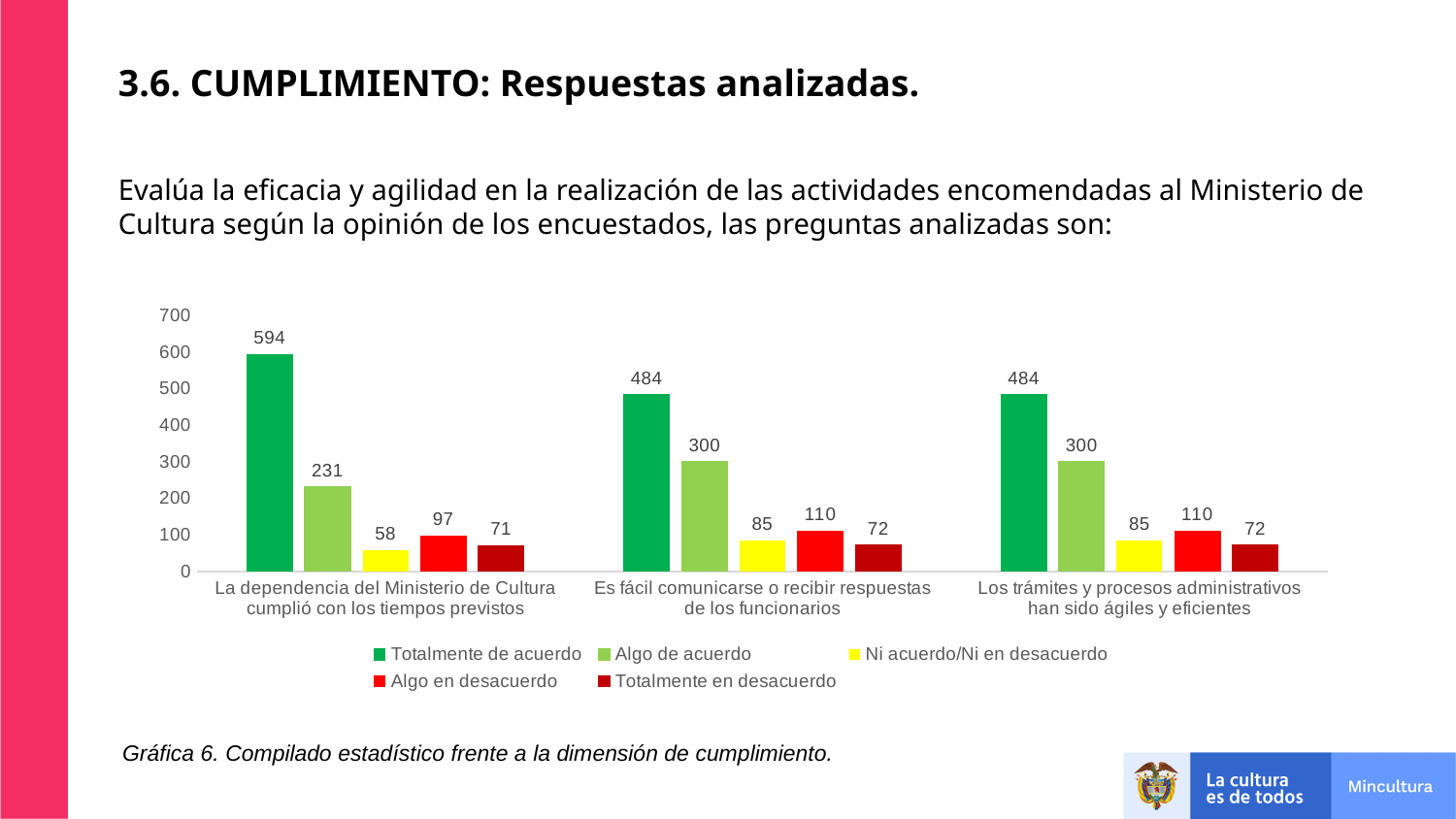
What colour represents 'Totalmente en desacuerdo' in the legend? Dark red Is the value for 'Algo de acuerdo' for 'La dependencia del Ministerio de Cultura cumplió con los tiempos previstos' greater or less than 200? greater What is the difference between 'Totalmente de acuerdo' and 'Algo de acuerdo' for 'La dependencia del Ministerio de Cultura cumplió con los tiempos previstos'? 363 How many series does the legend list? 5 Which is larger for 'Es fácil comunicarse o recibir respuestas de los funcionarios': 'Algo en desacuerdo' or 'Totalmente en desacuerdo'? Algo en desacuerdo What kind of chart is shown on the slide? Bar chart What is the value for 'Ni acuerdo/Ni en desacuerdo' for 'Los trámites y procesos administrativos han sido ágiles y eficientes'? 85 Which response option has the lowest value for 'La dependencia del Ministerio de Cultura cumplió con los tiempos previstos'? Ni acuerdo/Ni en desacuerdo What is the value for 'Algo de acuerdo' for 'Es fácil comunicarse o recibir respuestas de los funcionarios'? 300 How many question categories are shown on the x axis? 3 What is the value for 'Totalmente de acuerdo' for 'La dependencia del Ministerio de Cultura cumplió con los tiempos previstos'? 594 Which response option has the highest value for 'La dependencia del Ministerio de Cultura cumplió con los tiempos previstos'? Totalmente de acuerdo